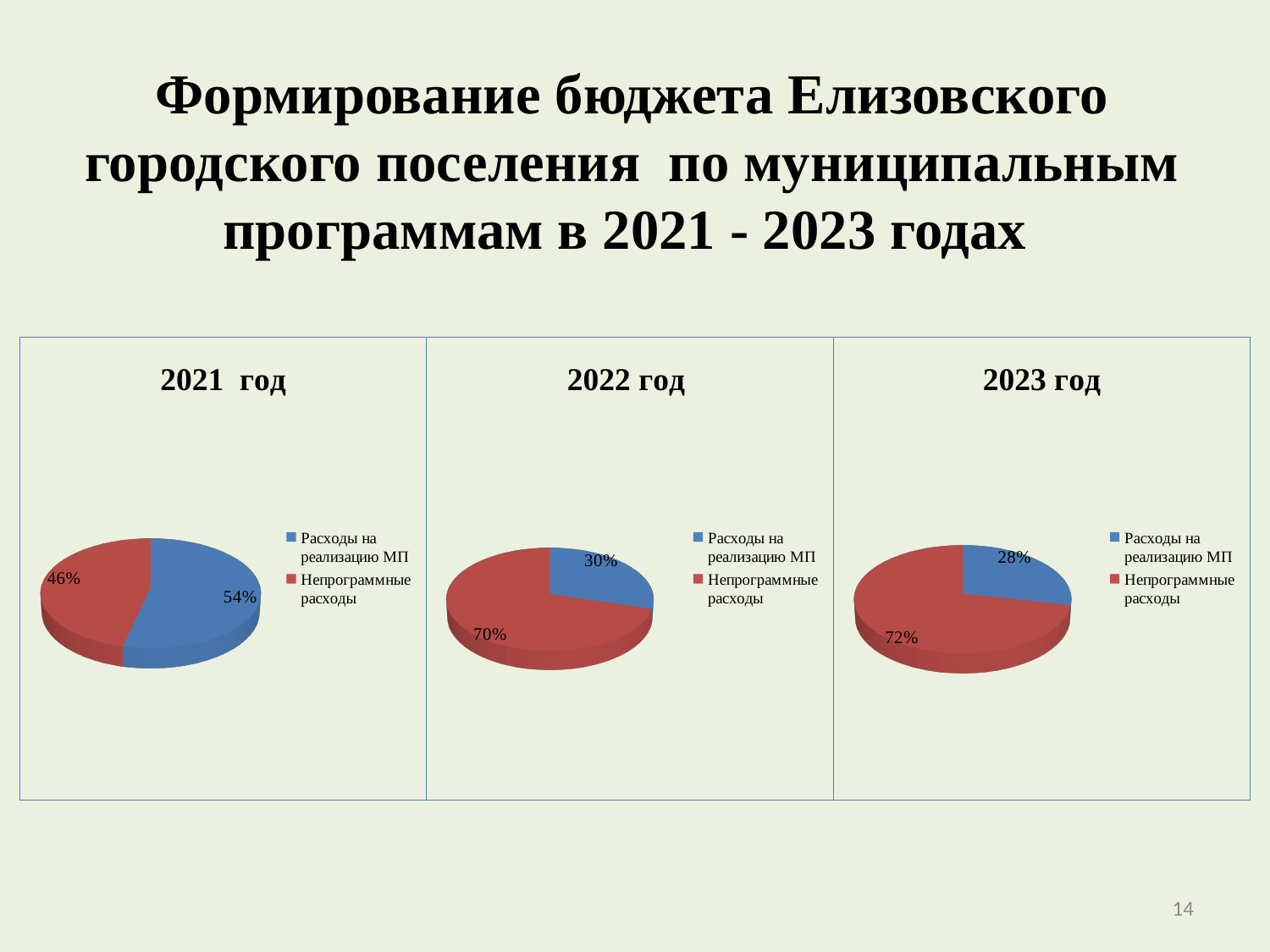
What kind of chart is the 2022 год chart? Pie chart How many series does the legend of the 2023 год chart list? 2 In the 2022 год chart, what is the difference between the Непрограммные расходы share and the Расходы на реализацию МП share? 40% In the 2021 год chart, what share is labelled for Расходы на реализацию МП? 54% In the 2022 год chart, what share is labelled for Непрограммные расходы? 70% In the 2021 год chart, which colour represents Непрограммные расходы? Red In the 2022 год chart, what share is labelled for Расходы на реализацию МП? 30% In the 2021 год chart, what share is labelled for Непрограммные расходы? 46% In the 2023 год chart, what share is labelled for Непрограммные расходы? 72% In the 2023 год chart, what share is labelled for Расходы на реализацию МП? 28% In the 2021 год chart, which slice is the largest? Расходы на реализацию МП In the 2023 год chart, which slice is the smallest? Расходы на реализацию МП